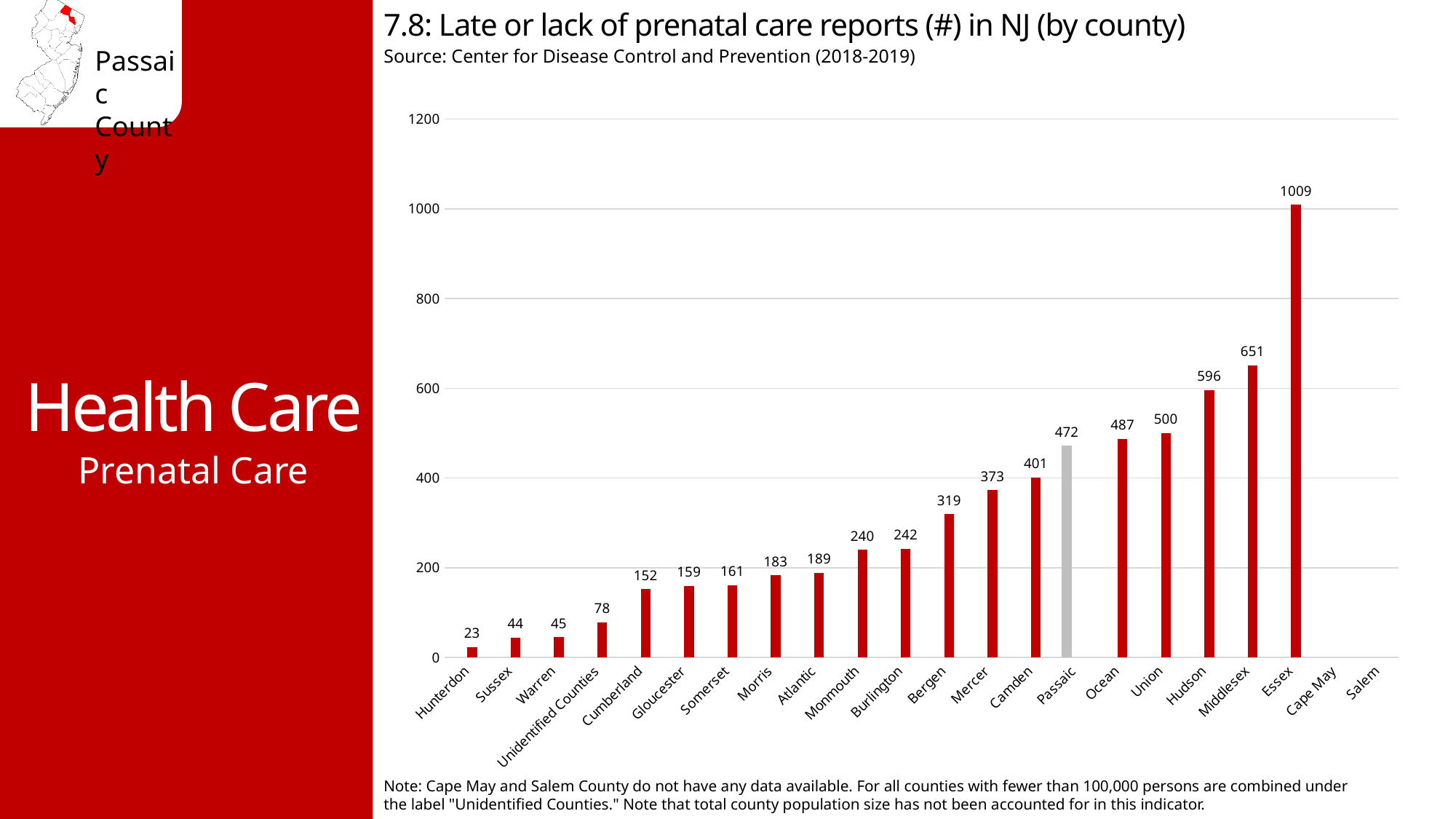
How many county labels are shown on the x axis? 22 What is the difference between the values for Essex and Middlesex? 358 What is the difference between the values for Passaic and Camden? 71 What is the value shown for Unidentified Counties? 78 What kind of chart is shown on the slide? Bar chart What is the number of late or lack of prenatal care reports for Passaic County? 472 Which county has the highest number of late or lack of prenatal care reports? Essex Which county with a plotted bar has the lowest number of reports? Hunterdon What is the value shown for Essex County? 1009 Is the value for Bergen greater or less than 400? less Which bar is coloured grey instead of red? Passaic Which has a larger value, Hudson or Union? Hudson